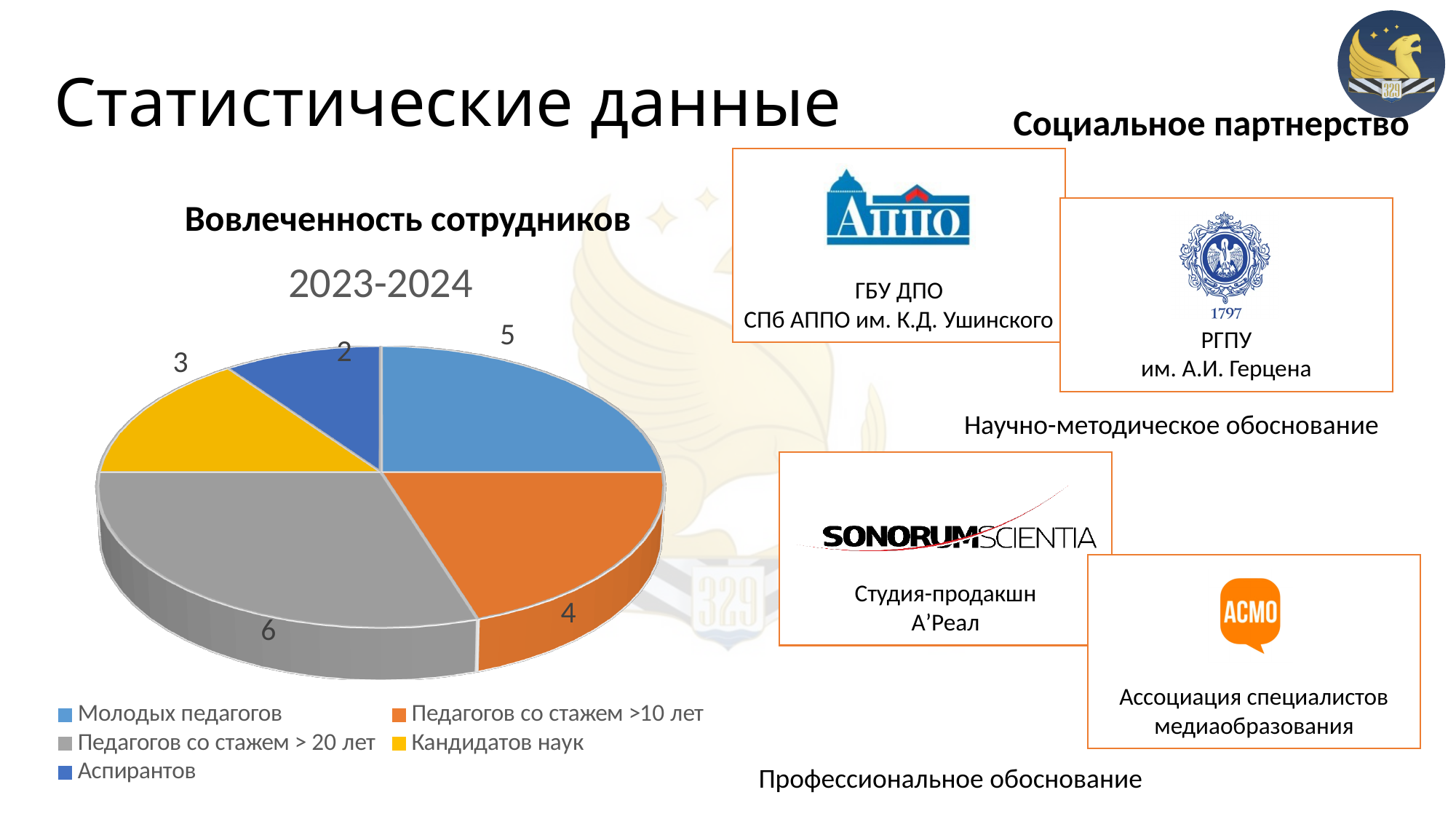
What is the difference between the values for Педагогов со стажем > 20 лет and Аспирантов? 4 What is the value for Молодых педагогов in the pie chart? 5 What share of the pie does Педагогов со стажем > 20 лет represent? 30% Which category has the smallest slice in the pie chart? Аспирантов Which is larger: the value for Молодых педагогов or the value for Педагогов со стажем >10 лет? Молодых педагогов How many categories does the pie chart have? 5 What is the value for Кандидатов наук in the pie chart? 3 What is the value for Аспирантов in the pie chart? 2 What is the value for Педагогов со стажем > 20 лет in the pie chart? 6 What period is shown as the pie chart's title? 2023-2024 Which category has the largest slice in the pie chart? Педагогов со стажем > 20 лет What type of chart is shown on the slide? Pie chart